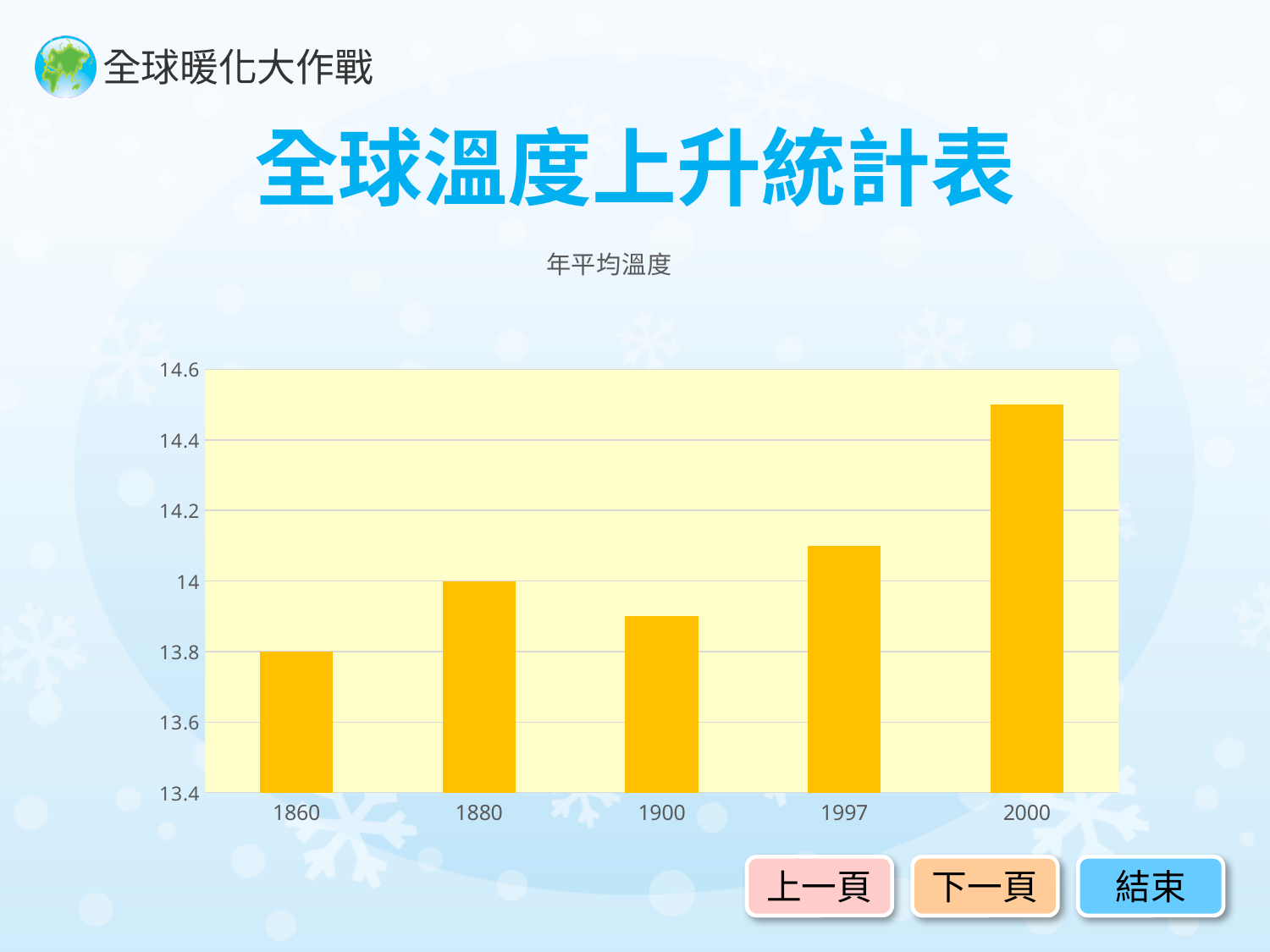
Is the value for 1997 greater or less than 14? greater What type of chart is shown on the slide? bar chart Which year has the lowest value in the chart? 1860 What is the title of the chart? 年平均溫度 What is the difference between the values for 1880 and 1860? 0.2 Is the value for 2000 greater or less than 14.4? greater How many years (categories) are shown on the x axis of the chart? 5 What is the value for 1880 in the chart? 14 Which has the larger value, 1880 or 1900? 1880 Is the value for 1900 greater or less than 14? less What is the value for 1860 in the chart? 13.8 Which year has the highest value in the chart? 2000